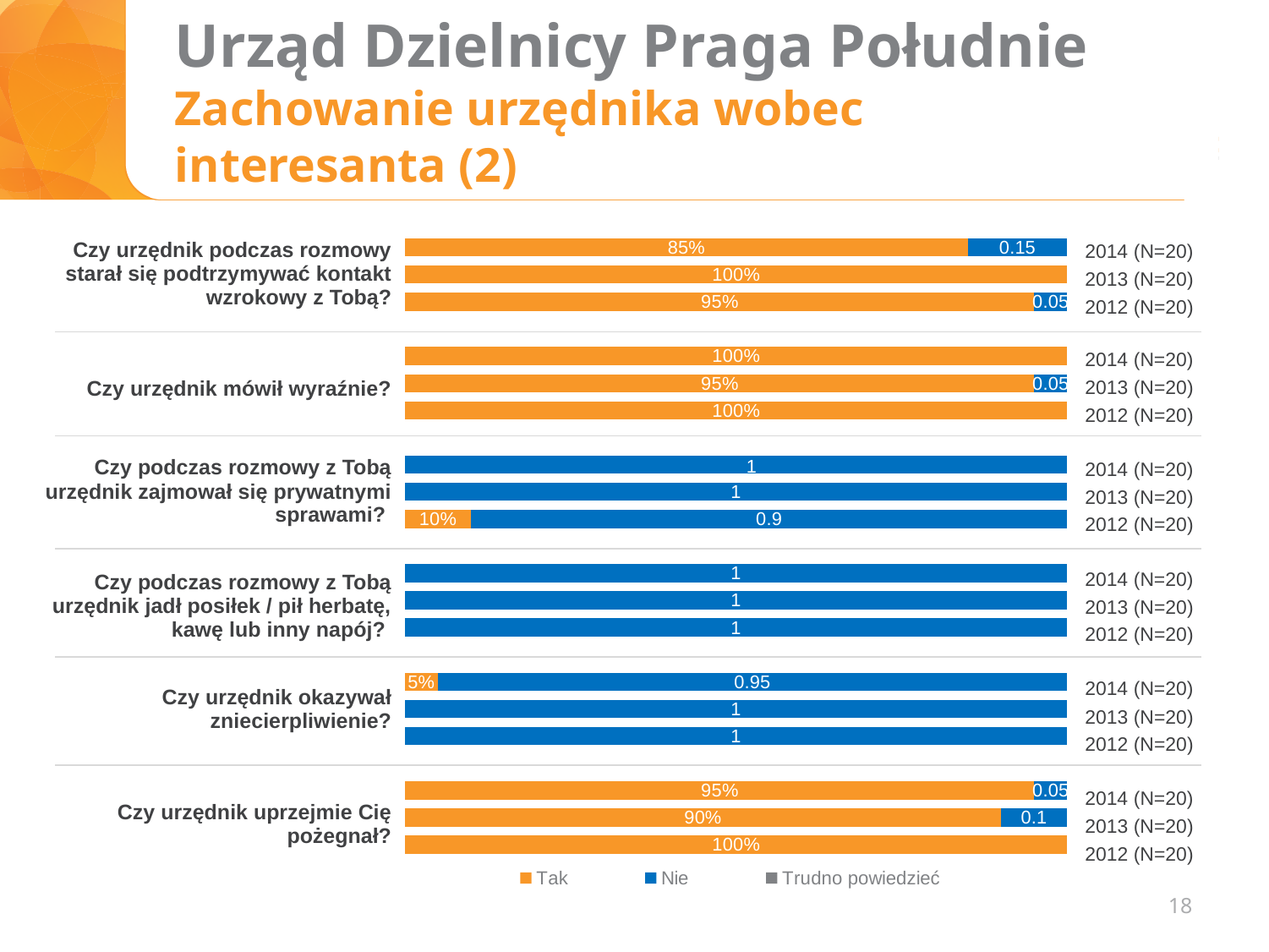
What is the 'Tak' value for 2013 (N=20) for the question 'Czy urzędnik uprzejmie Cię pożegnał?' 90% What kind of chart is shown on the slide? bar chart For the question 'Czy urzędnik podczas rozmowy starał się podtrzymywać kontakt wzrokowy z Tobą?', which year has the lowest 'Tak' value? 2014 (N=20) What is the 'Nie' value for 2014 (N=20) for the question 'Czy urzędnik okazywał zniecierpliwienie?' 0.95 How many survey questions are shown on the chart? 6 What is the 'Tak' value for 2013 (N=20) for the question 'Czy urzędnik mówił wyraźnie?' 95% What is the 'Tak' value for 2012 (N=20) for the question 'Czy podczas rozmowy z Tobą urzędnik zajmował się prywatnymi sprawami?' 10% What is the 'Tak' value for 2014 (N=20) for the question 'Czy urzędnik podczas rozmowy starał się podtrzymywać kontakt wzrokowy z Tobą?' 85% How many series does the legend list? 3 For the question 'Czy urzędnik uprzejmie Cię pożegnał?', which year has the higher 'Tak' value: 2014 (N=20) or 2013 (N=20)? 2014 (N=20) What are the legend entries of the chart? Tak, Nie, Trudno powiedzieć What is the 'Nie' value for 2014 (N=20) for the question 'Czy urzędnik podczas rozmowy starał się podtrzymywać kontakt wzrokowy z Tobą?' 0.15